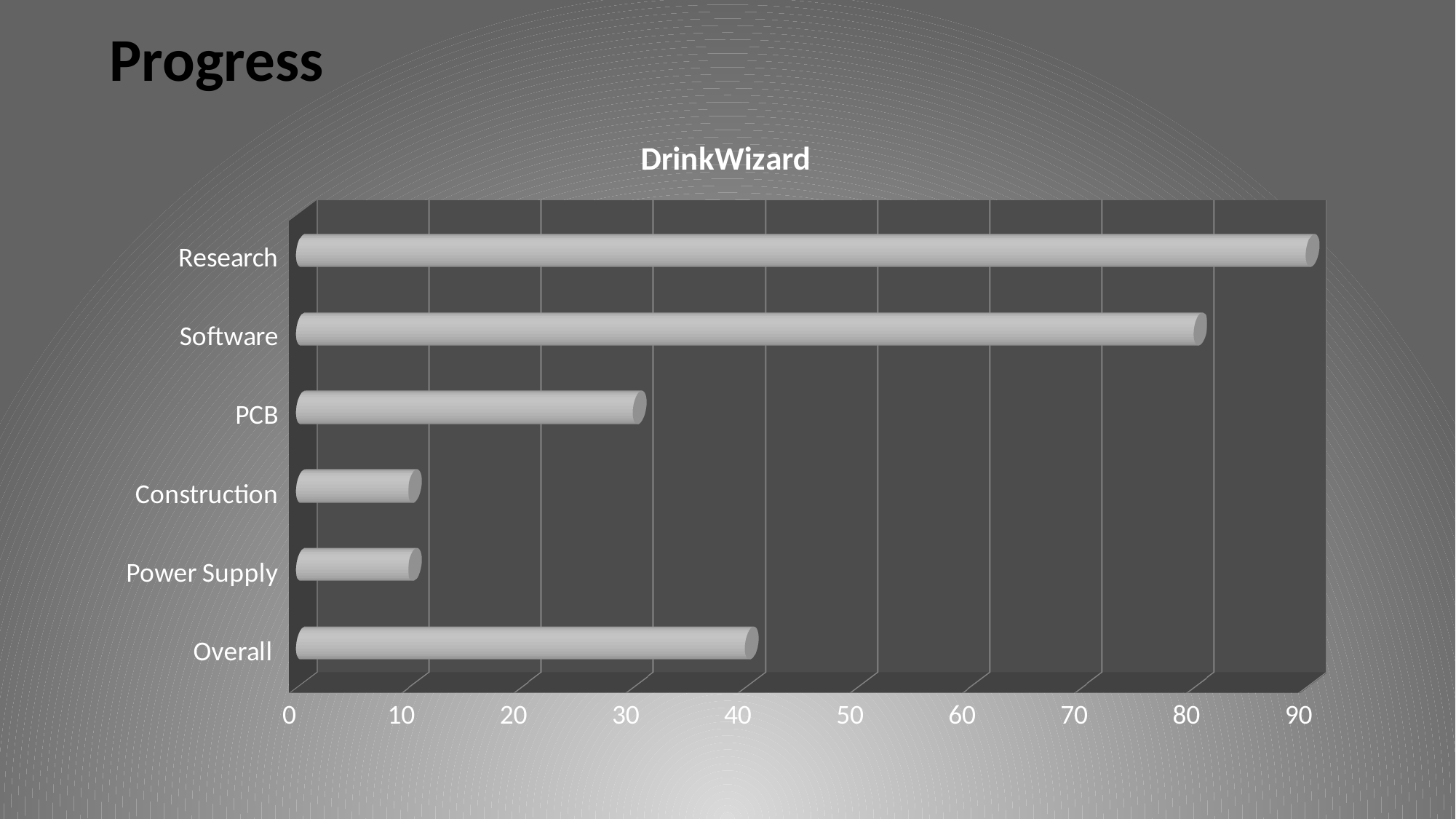
Is the value for PCB greater or less than 40? less Is the value for Overall greater or less than 30? greater Which has the larger value, PCB or Overall? Overall Is the value for Research greater or less than 80? greater How many categories are plotted in the chart? 6 Which category has the highest value? Research What kind of chart is shown on the slide? bar chart Which has the larger value, Software or PCB? Software What is the title of the chart? DrinkWizard Which has the larger value, Research or Software? Research